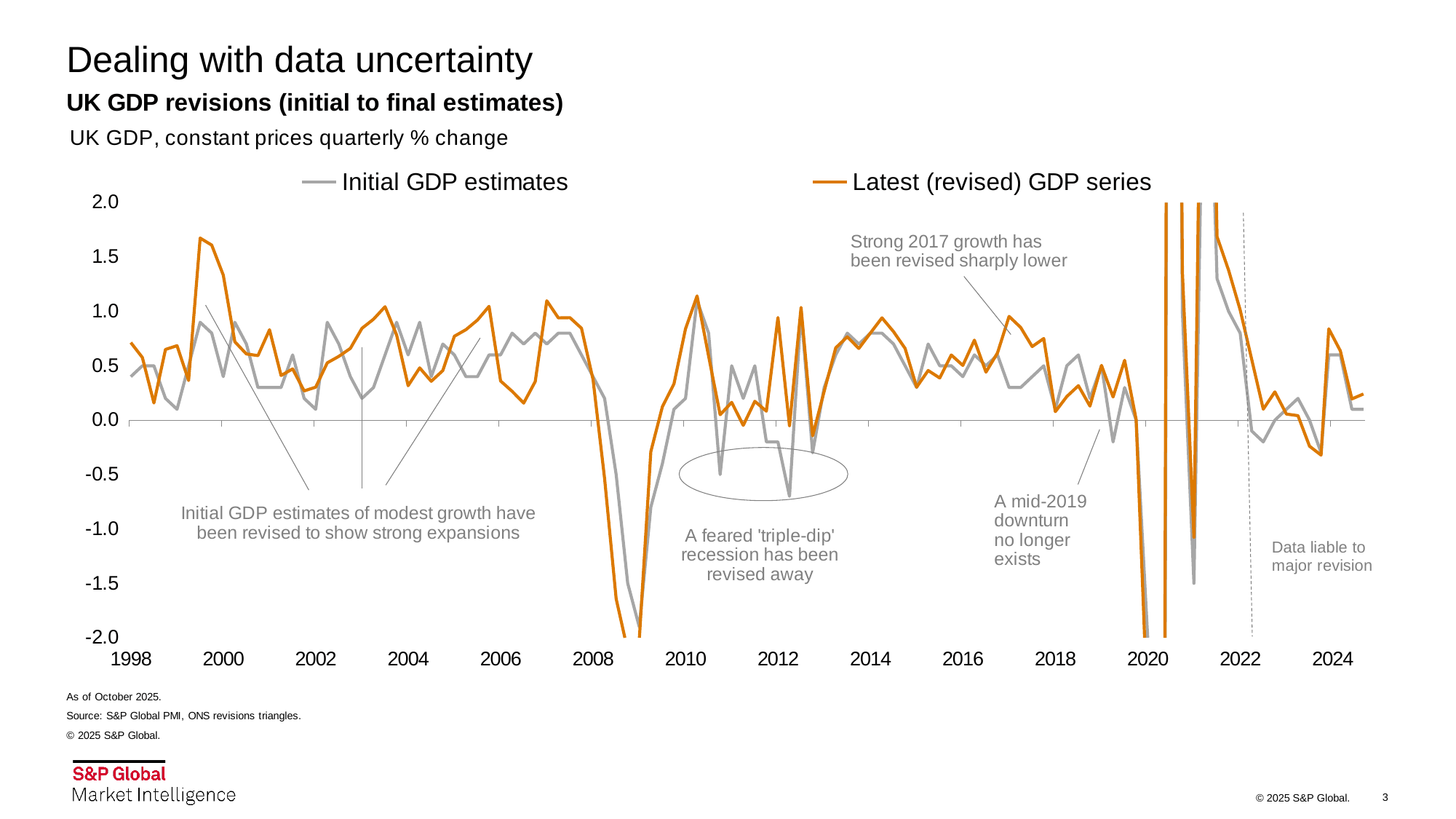
Around 2017, which series shows the higher value: 'Initial GDP estimates' or 'Latest (revised) GDP series'? Latest (revised) GDP series Around 2003, which series shows the higher value: 'Initial GDP estimates' or 'Latest (revised) GDP series'? Latest (revised) GDP series What is the highest value shown on the y axis? 2.0 What is the title of the chart? UK GDP revisions (initial to final estimates) In mid-2019, is the 'Initial GDP estimates' value greater or less than 0.0? less How many series does the legend list? 2 In mid-2019, is the 'Latest (revised) GDP series' value greater or less than 0.0? greater Which colour is used for the 'Latest (revised) GDP series' line? orange Is the lowest point of the 'Initial GDP estimates' line around 2012 greater or less than -0.5? less What kind of chart is shown on the slide? line chart